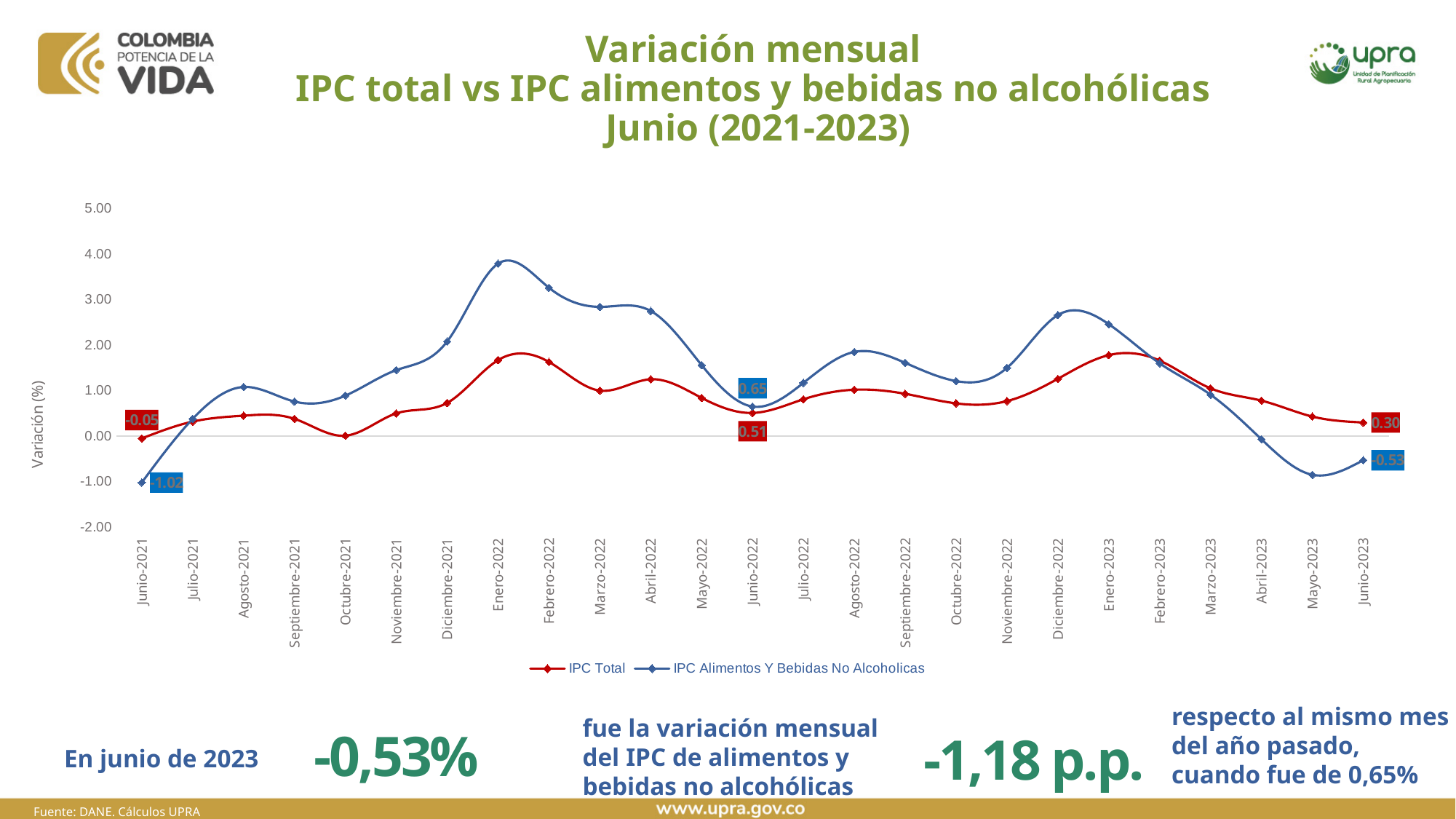
What is the value of IPC Alimentos Y Bebidas No Alcoholicas for Junio-2021? -1.02 In which month does IPC Alimentos Y Bebidas No Alcoholicas reach its highest value? Enero-2022 How many months are plotted on the x axis? 25 What kind of chart is shown on the slide? Line chart How many series does the legend list? 2 What is the value of IPC Total for Junio-2023? 0.30 What is the value of IPC Alimentos Y Bebidas No Alcoholicas for Junio-2023? -0.53 What is the value of IPC Total for Junio-2021? -0.05 What is the value of IPC Alimentos Y Bebidas No Alcoholicas for Junio-2022? 0.65 In Junio-2022, which series has the higher value, IPC Total or IPC Alimentos Y Bebidas No Alcoholicas? IPC Alimentos Y Bebidas No Alcoholicas Is the value of IPC Alimentos Y Bebidas No Alcoholicas for Enero-2022 greater or less than 3.00? greater What is the difference between IPC Total and IPC Alimentos Y Bebidas No Alcoholicas in Junio-2023? 0.83